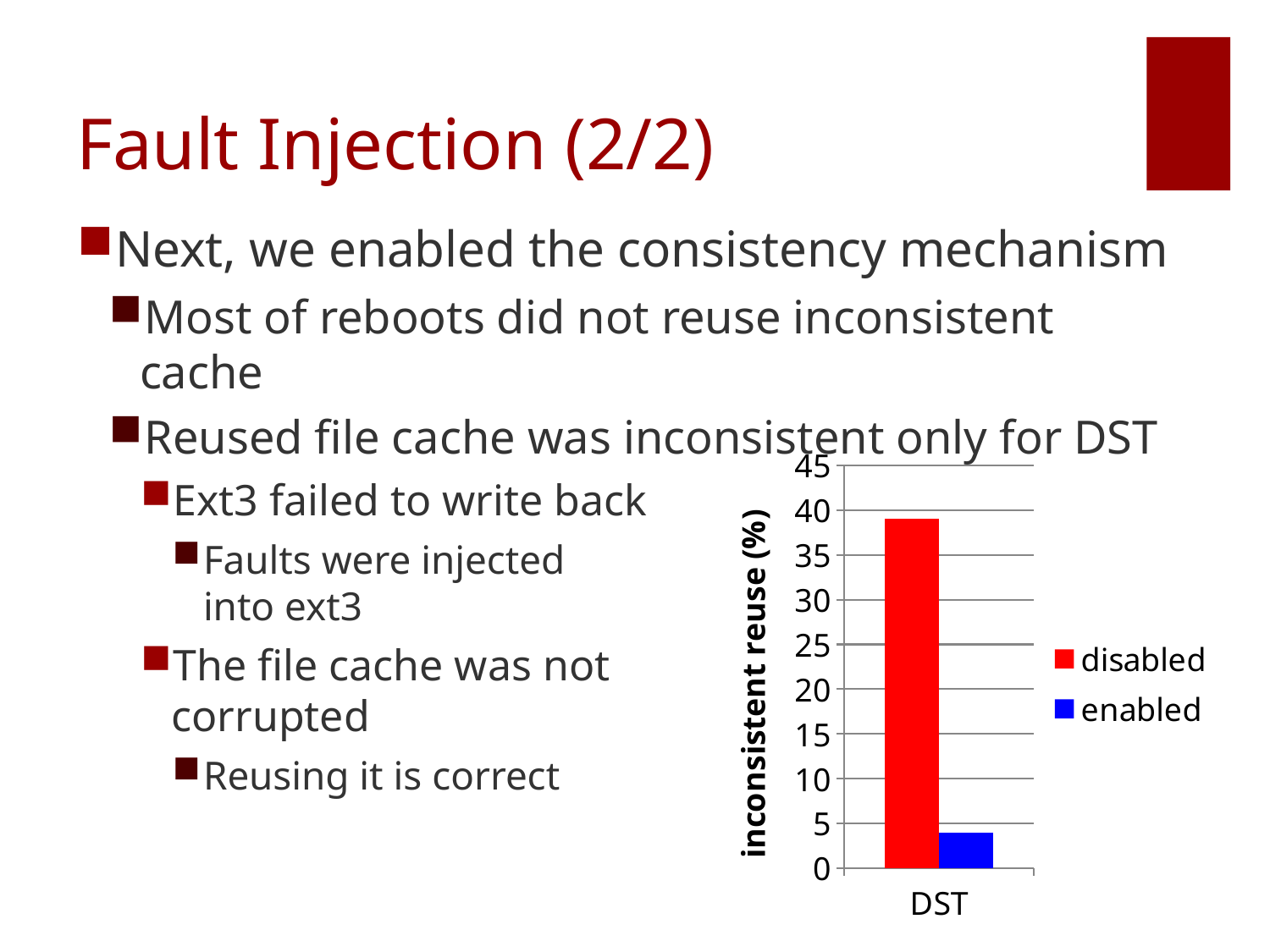
Is the value for disabled at DST greater or less than 35? greater How many categories are shown on the x axis of the chart? 1 What is the only category shown on the x axis of the chart? DST Is the value for disabled at DST greater or less than 40? less Which series has the lowest value in the chart? enabled Which series has the higher value for DST, disabled or enabled? disabled Which series has the highest value in the chart? disabled What kind of chart is shown on the slide? bar chart Is the value for enabled at DST greater or less than 5? less How many series does the chart's legend list? 2 What is the title of the chart's y axis? inconsistent reuse (%)